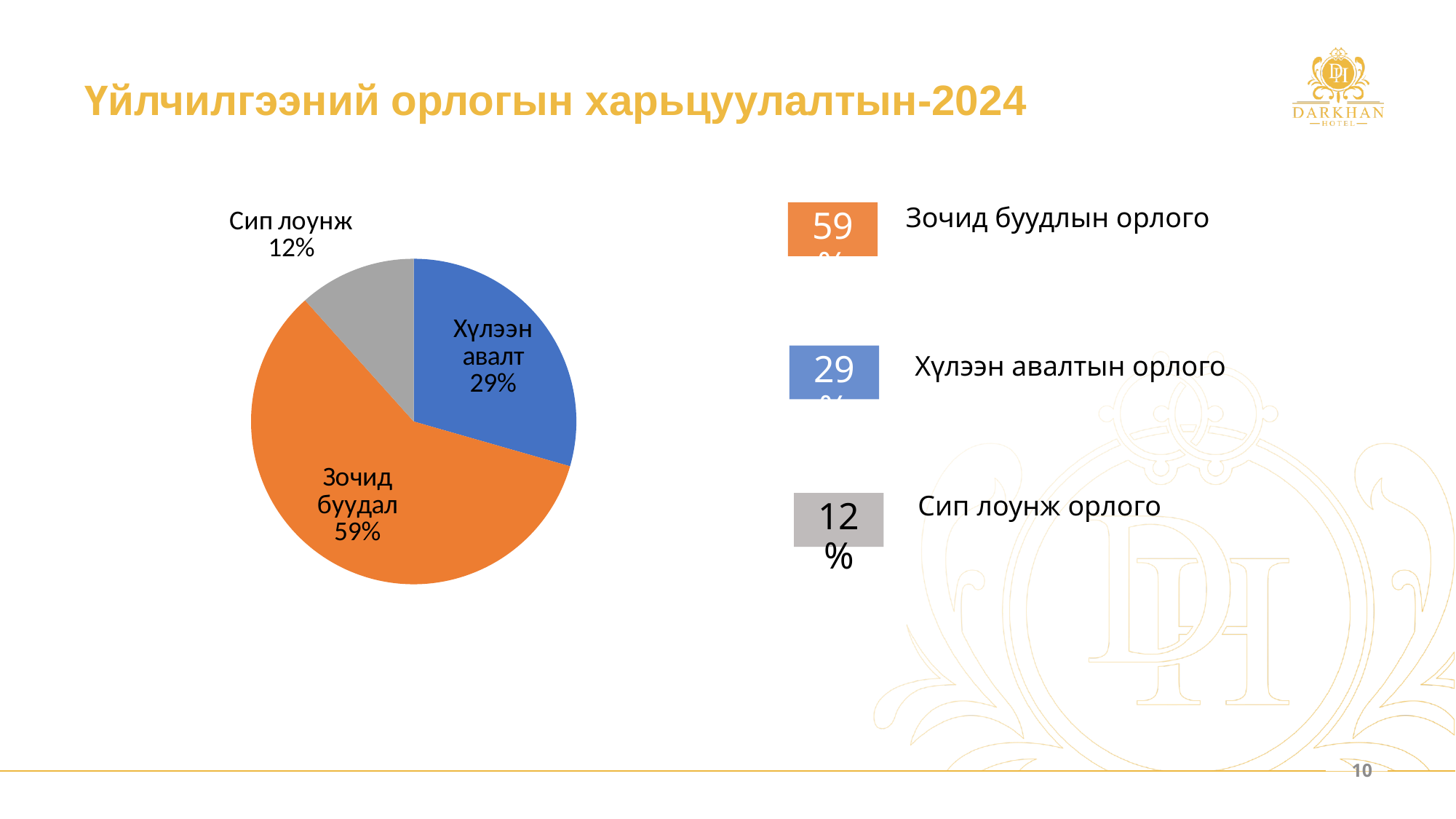
Which is larger, the share for Хүлээн авалт or the share for Сип лоунж? Хүлээн авалт What share of the pie does Хүлээн авалт have? 29% How many slices does the pie chart have? 3 What colour is the Сип лоунж slice? Grey What is the difference in percentage points between Хүлээн авалт and Сип лоунж? 17 What share of the pie does Сип лоунж have? 12% What share of the pie does Зочид буудал have? 59% Which category has the largest slice of the pie? Зочид буудал What is the difference in percentage points between Зочид буудал and Хүлээн авалт? 30 What colour is the Зочид буудал slice? Orange What kind of chart is shown on the slide? Pie chart Which category has the smallest slice of the pie? Сип лоунж